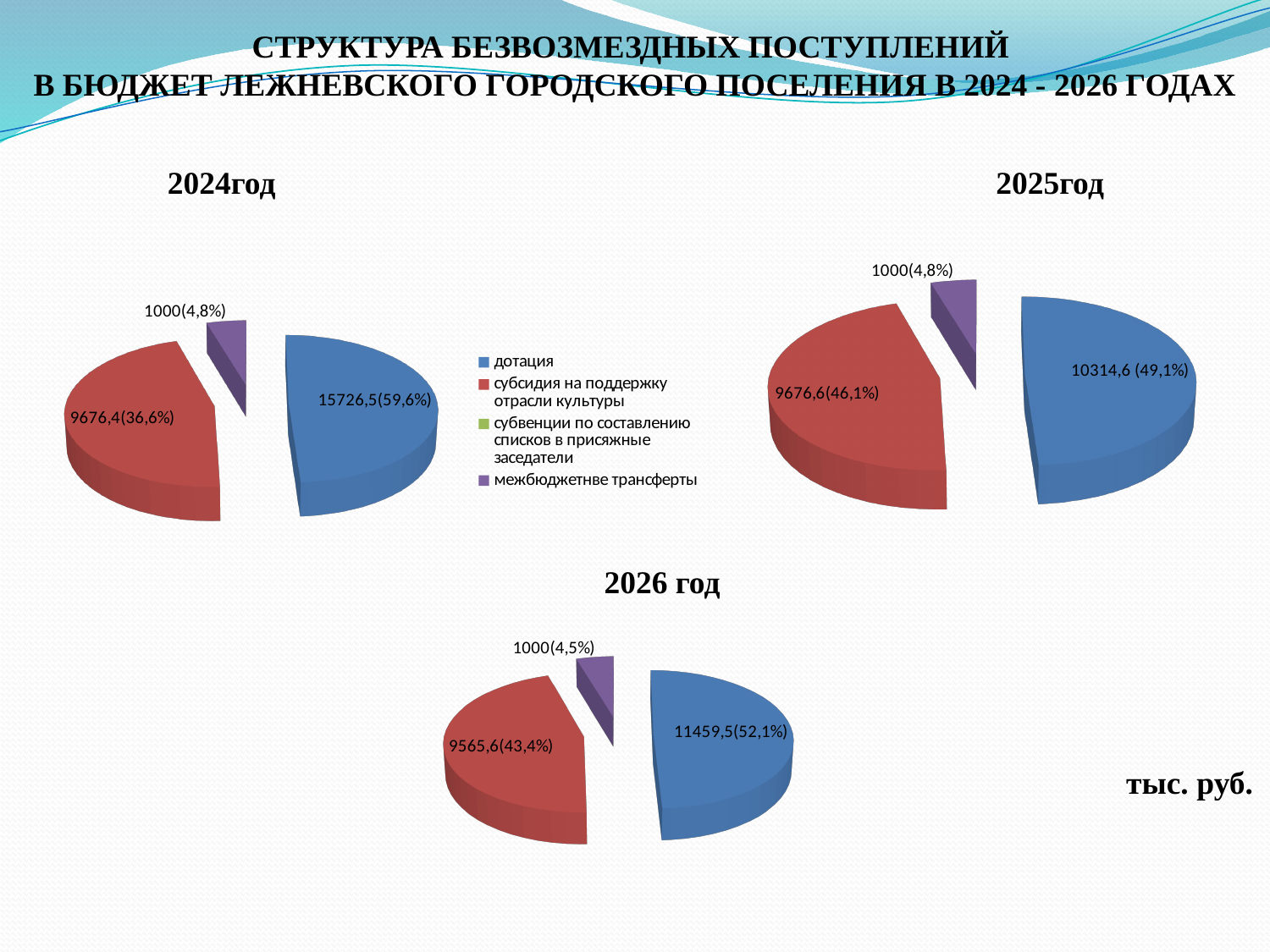
In the 2024год pie chart, which category has the largest slice? дотация In the 2026 год pie chart, which category has the smallest slice? межбюджетные трансферты In the 2024год pie chart, what is the difference between the values for дотация and субсидия на поддержку отрасли культуры? 6050,1 In the 2025год pie chart, which is larger: дотация or субсидия на поддержку отрасли культуры? дотация In the 2024год pie chart, what share of the total does субсидия на поддержку отрасли культуры have? 36,6% How many entries does the legend on the slide list? 4 In the 2025год pie chart, what share does межбюджетные трансферты have? 4,8% What type of chart is used for the 2026 год data? Pie chart In the 2024год pie chart, what value is shown for дотация? 15726,5 In the 2025год pie chart, what value is shown for дотация? 10314,6 In the 2026 год pie chart, what share does дотация have? 52,1% In the 2026 год pie chart, what value is shown for субсидия на поддержку отрасли культуры? 9565,6